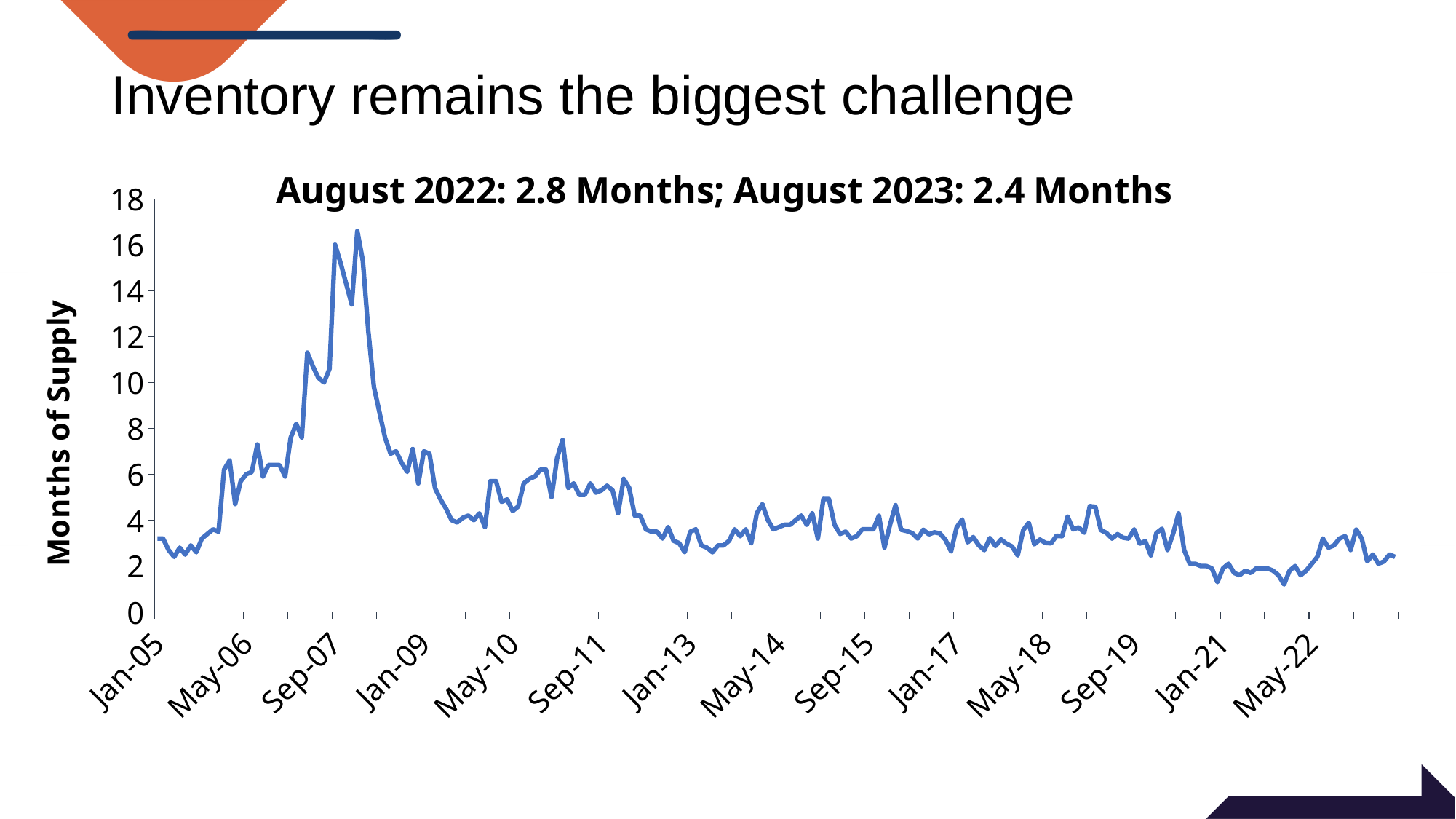
Is the value at Jan-13 greater or less than 4? less According to the chart title, what was the months of supply in August 2023? 2.4 Months Is the peak value of the line greater or less than 14? greater According to the chart title, what was the months of supply in August 2022? 2.8 Months What type of chart is shown on the slide? line chart Which was higher, months of supply in August 2022 or August 2023? August 2022 Is the value at Jan-05 greater or less than 4? less By how much did months of supply change from August 2022 to August 2023? 0.4 Months Between which two labelled x-axis ticks does the line reach its highest value? Sep-07 and Jan-09 What is the label of the vertical axis? Months of Supply Does the line rise or fall between its peak after Sep-07 and Jan-09? fall